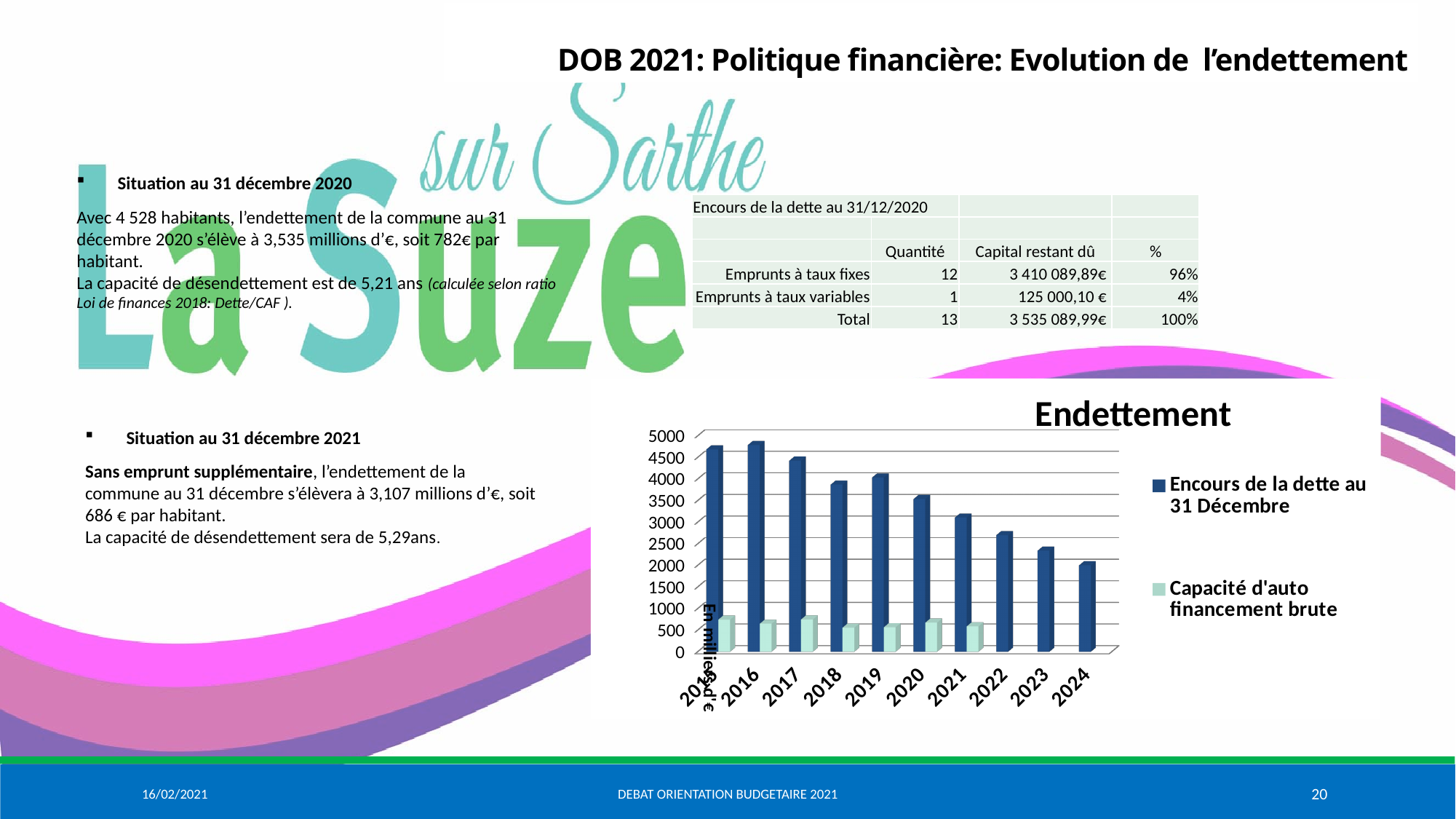
In the "Endettement" chart, is the value for "Capacité d'auto financement brute" in 2015 greater or less than 1000? less In the "Endettement" chart, which is larger for "Encours de la dette au 31 Décembre": 2017 or 2020? 2017 In the "Endettement" chart, is the value for "Encours de la dette au 31 Décembre" in 2024 greater or less than 2500? less What is the title of the bar chart on the slide? Endettement In the "Endettement" chart, which year has the lowest value for "Encours de la dette au 31 Décembre"? 2024 In the "Endettement" chart, does "Encours de la dette au 31 Décembre" rise or fall from 2020 to 2024? fall In the "Endettement" chart, which colour represents "Capacité d'auto financement brute"? light green In the "Endettement" chart, is the value for "Encours de la dette au 31 Décembre" in 2015 greater or less than 4000? greater How many years are shown on the x axis of the "Endettement" chart? 10 How many series does the legend of the "Endettement" chart list? 2 What kind of chart is the "Endettement" chart? bar chart